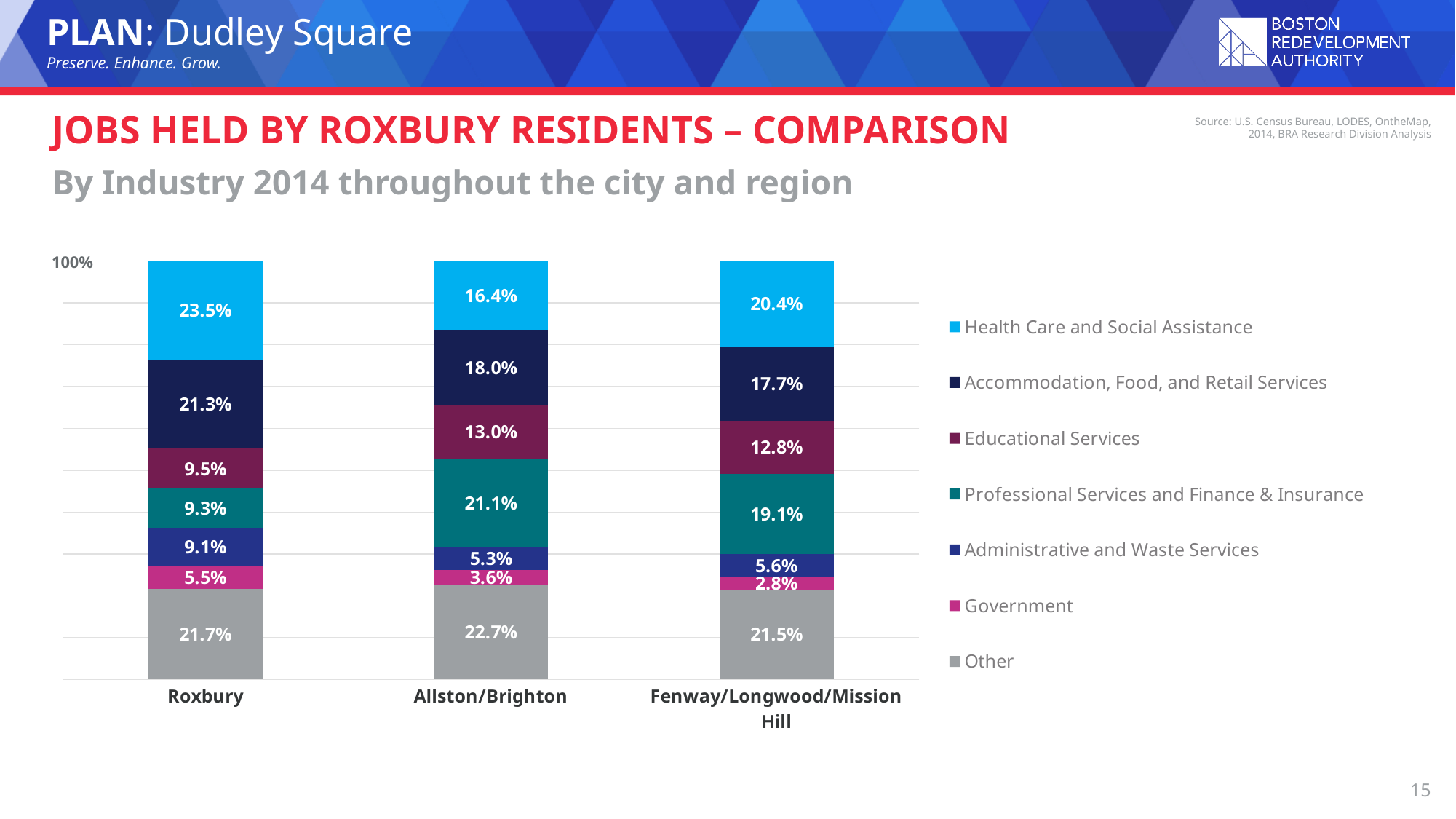
What is the Professional Services and Finance & Insurance share for Allston/Brighton? 21.1% How many neighborhoods are shown on the x axis? 3 What is the Other share for Allston/Brighton? 22.7% Which neighborhood has the highest Health Care and Social Assistance share? Roxbury Which neighborhood has the lowest Government share? Fenway/Longwood/Mission Hill What percentage of jobs held by Roxbury residents are in Health Care and Social Assistance? 23.5% What kind of chart is shown on the slide? Stacked bar chart How many series does the legend list? 7 What is the Government share for Fenway/Longwood/Mission Hill? 2.8% Which is larger: the Educational Services share for Roxbury or for Allston/Brighton? Allston/Brighton What is the difference in percentage points between the Health Care and Social Assistance share for Roxbury and for Allston/Brighton? 7.1 Which series is shown in gray at the bottom of each bar? Other